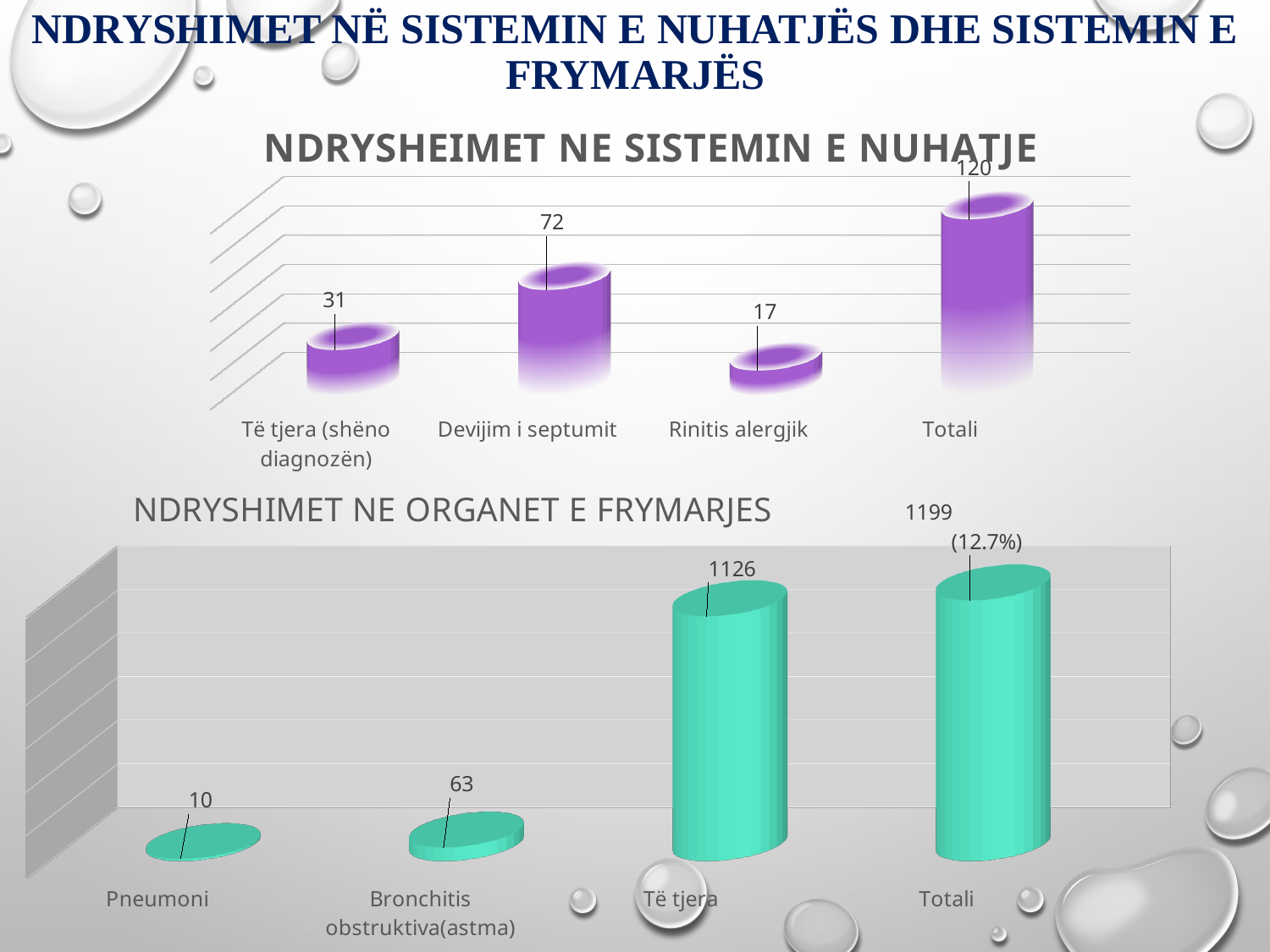
In the chart titled "NDRYSHIMET NE ORGANET E FRYMARJES", what percentage is shown next to the Totali value? 12.7% In the chart titled "NDRYSHEIMET NE SISTEMIN E NUHATJE", which category other than Totali has the lowest value? Rinitis alergjik In the chart titled "NDRYSHEIMET NE SISTEMIN E NUHATJE", what is the value for Devijim i septumit? 72 In the chart titled "NDRYSHIMET NE ORGANET E FRYMARJES", what is the value for Bronchitis obstruktiva(astma)? 63 In the chart titled "NDRYSHIMET NE ORGANET E FRYMARJES", what is the value for Pneumoni? 10 In the chart titled "NDRYSHIMET NE ORGANET E FRYMARJES", what is the value for Të tjera? 1126 What kind of chart is the bottom chart titled "NDRYSHIMET NE ORGANET E FRYMARJES"? Bar chart In the chart titled "NDRYSHEIMET NE SISTEMIN E NUHATJE", what is the value for Totali? 120 In the chart titled "NDRYSHEIMET NE SISTEMIN E NUHATJE", what is the difference between Devijim i septumit and Të tjera (shëno diagnozën)? 41 In the chart titled "NDRYSHIMET NE ORGANET E FRYMARJES", which is larger, Bronchitis obstruktiva(astma) or Pneumoni? Bronchitis obstruktiva(astma) In the chart titled "NDRYSHEIMET NE SISTEMIN E NUHATJE", how many categories are shown on the x axis? 4 In the chart titled "NDRYSHEIMET NE SISTEMIN E NUHATJE", what is the value for Rinitis alergjik? 17